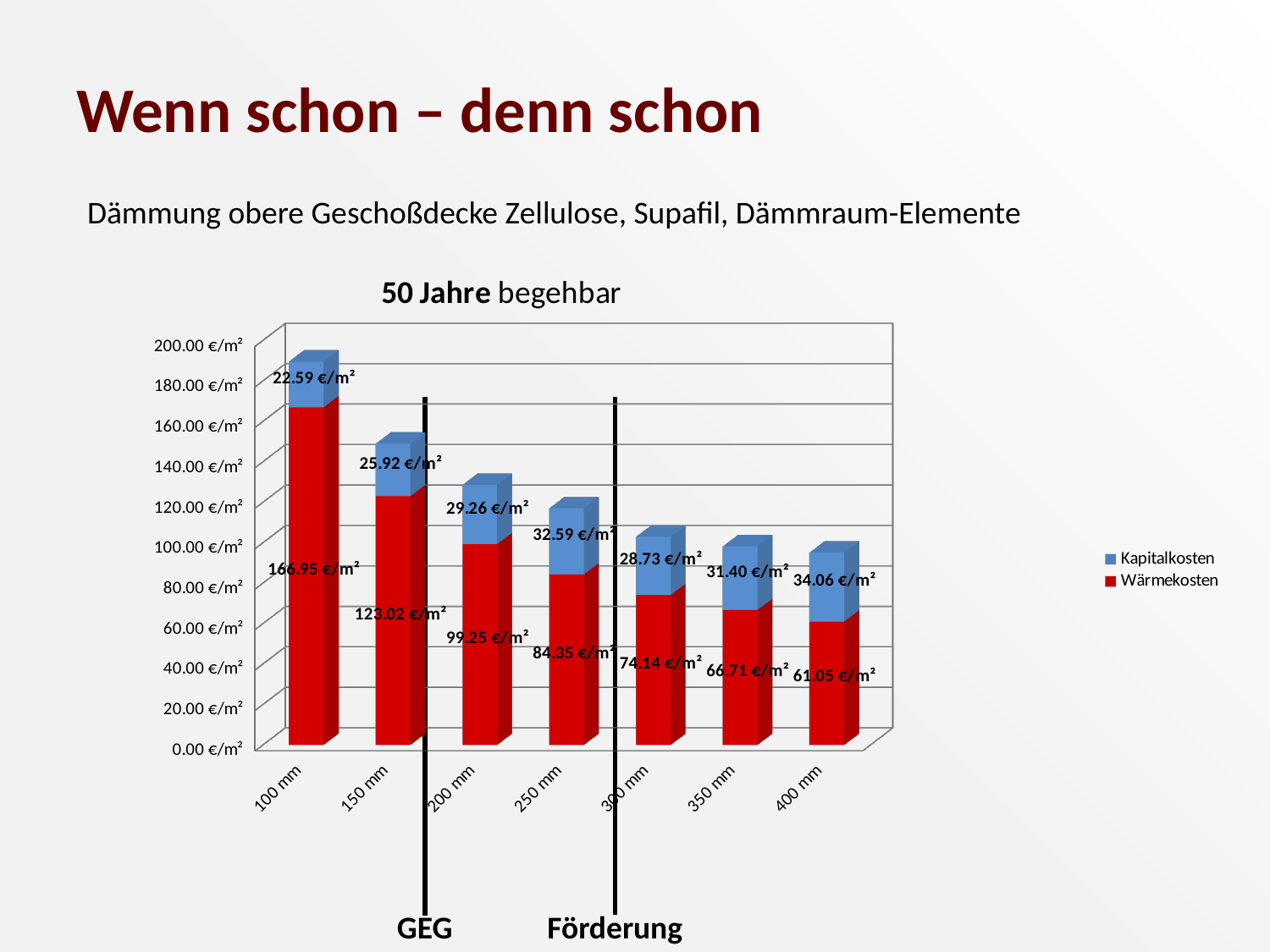
Which category has the highest Wärmekosten? 100 mm What is the difference between the Wärmekosten for 100 mm and 150 mm? 43.93 €/m² Do the Wärmekosten values rise or fall as the insulation thickness increases along the x axis? fall What is the Wärmekosten value for 250 mm? 84.35 €/m² Which category has the lowest Wärmekosten? 400 mm What is the total of the stacked bar for 200 mm? 128.51 €/m² What is the Wärmekosten value for 100 mm? 166.95 €/m² How many insulation thickness categories are shown on the x axis? 7 Which is larger, the Kapitalkosten for 250 mm or for 300 mm? 250 mm How many series does the legend list? 2 What type of chart is shown on the slide? stacked bar chart What is the Kapitalkosten value for 400 mm? 34.06 €/m²